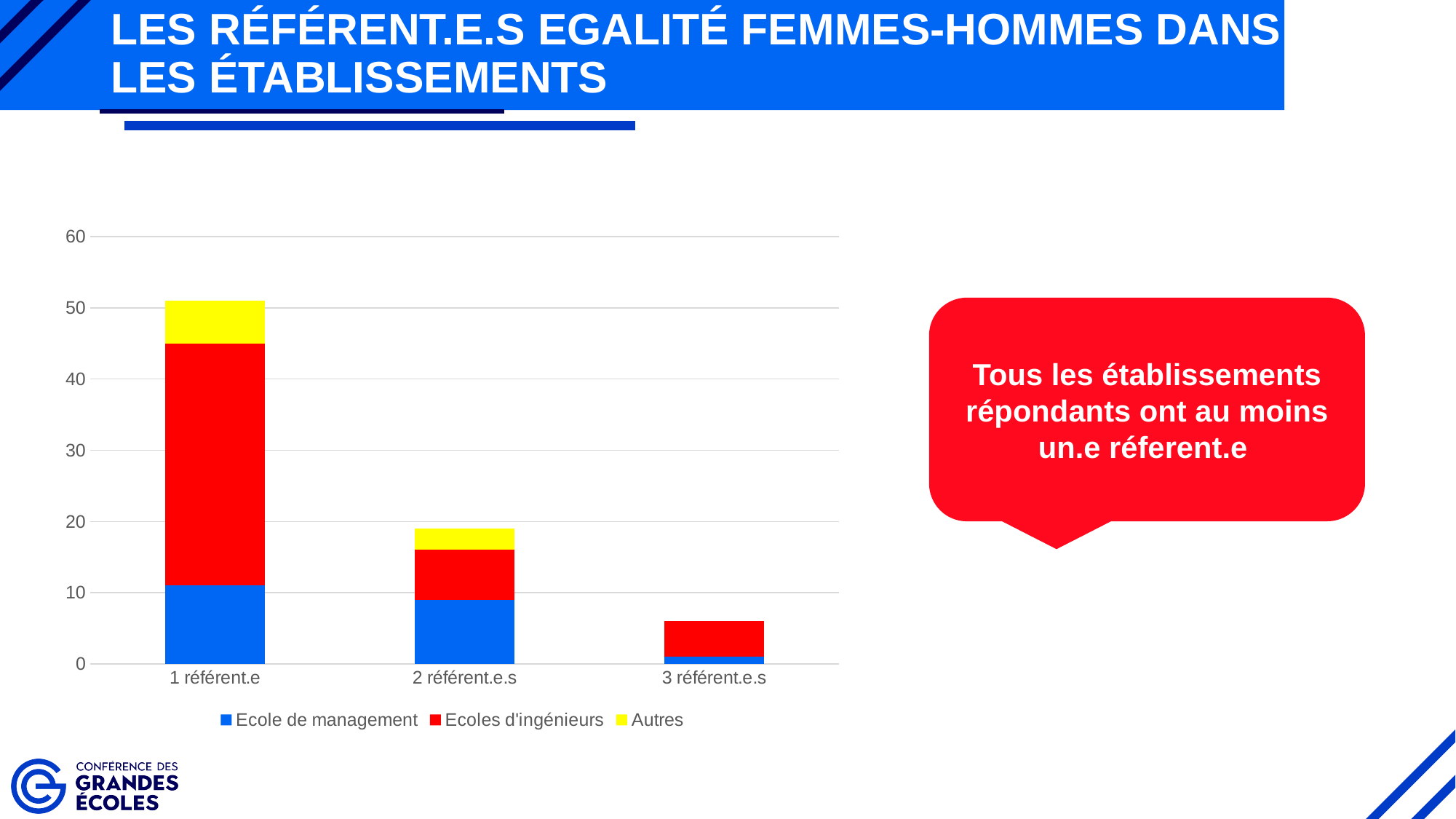
Is the total stacked value for '3 référent.e.s' greater or less than 10? less In the '1 référent.e' bar, which is larger: the Ecole de management segment or the Ecoles d'ingénieurs segment? Ecoles d'ingénieurs What kind of chart is shown on the slide? Stacked bar chart Do the total bar heights rise or fall from '1 référent.e' to '3 référent.e.s'? Fall Which category has the shortest stacked bar? 3 référent.e.s Is the Ecoles d'ingénieurs segment larger for '1 référent.e' or for '2 référent.e.s'? 1 référent.e Is the total stacked value for '1 référent.e' greater or less than 40? greater Which colour represents the 'Autres' series in the legend? Yellow How many categories are shown on the x axis of the chart? 3 How many series does the chart's legend list? 3 Which category has the tallest stacked bar? 1 référent.e Is the total stacked value for '2 référent.e.s' greater or less than 30? less